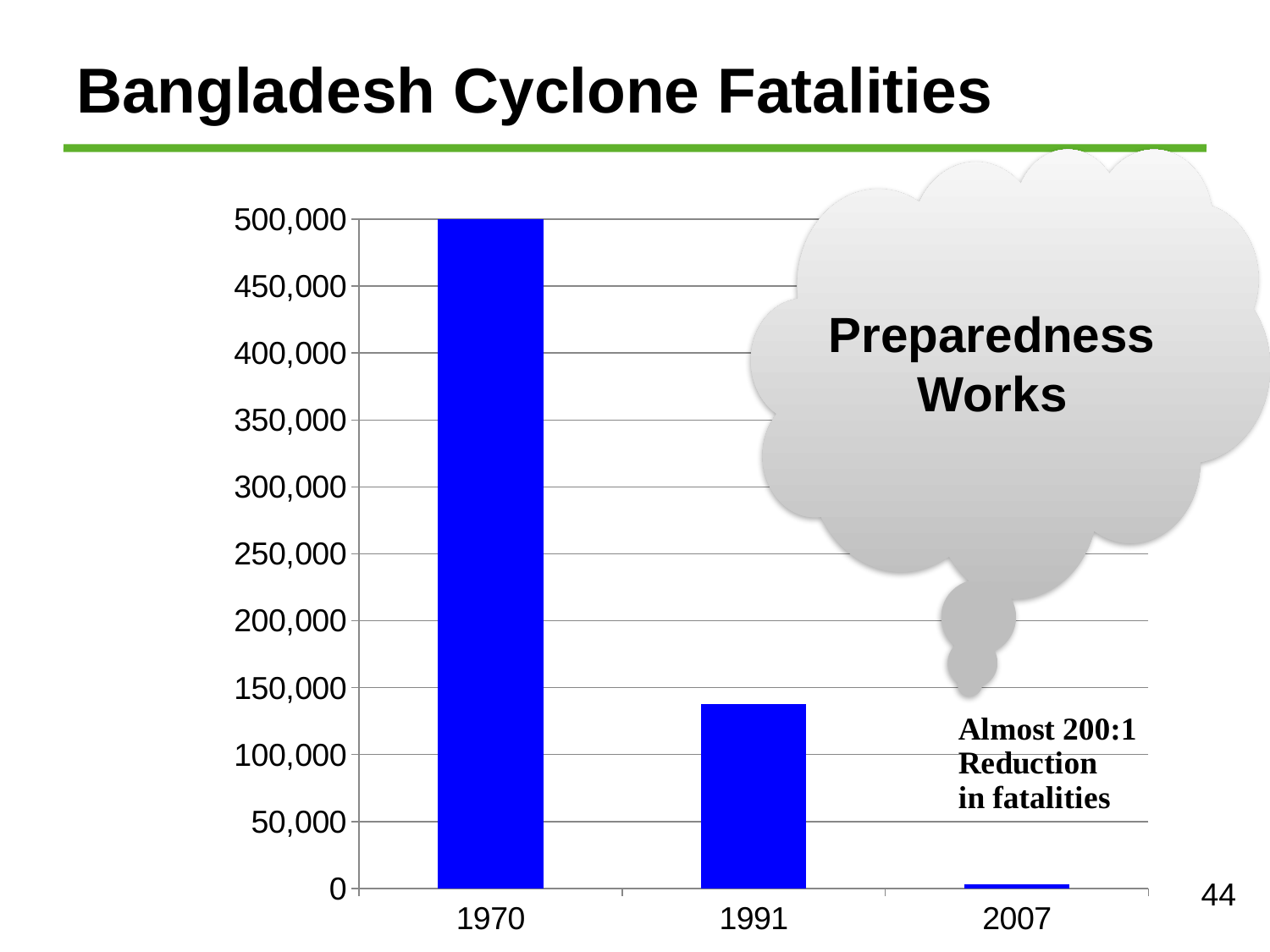
What is the value of the bar for 1970? 500,000 What colour are the bars in the chart? Blue Which year has more fatalities, 1970 or 1991? 1970 How many years are shown on the x axis of the chart? 3 Which year has the highest number of cyclone fatalities? 1970 Which year has the lowest number of cyclone fatalities? 2007 What is the title of the chart on the slide? Bangladesh Cyclone Fatalities Do the fatalities rise or fall from 1970 to 2007? Fall What type of chart is shown on the slide? Bar chart Is the value for 1991 greater or less than 100,000? greater Is the value for 2007 greater or less than 50,000? less Is the value for 1991 greater or less than 150,000? less